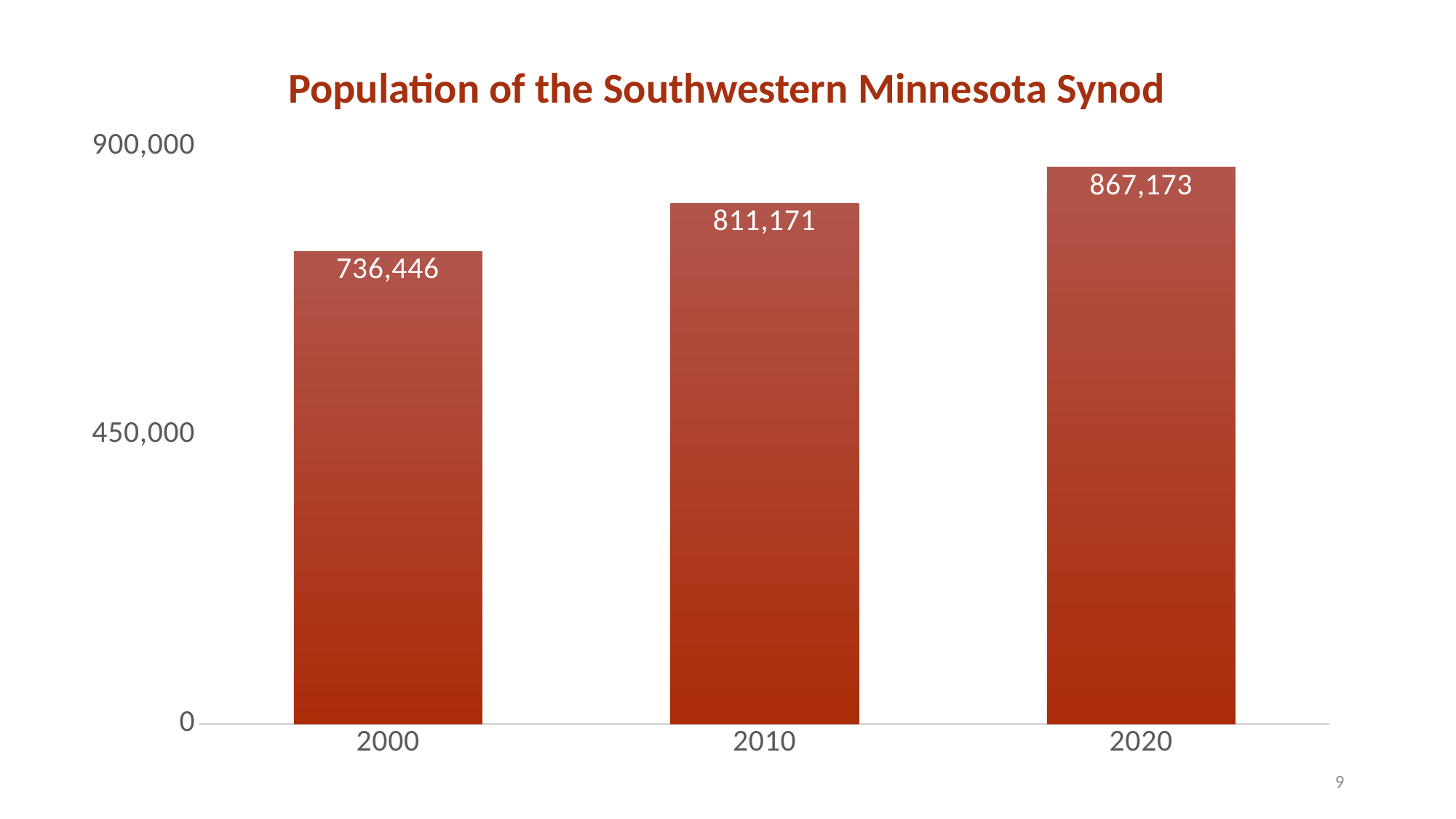
Is the population for 2000 greater or less than 450,000? greater Does the population rise or fall from 2000 to 2020? rise What is the population shown for 2010? 811,171 Which is larger, the population in 2010 or in 2020? 2020 Which year has the lowest population? 2000 How many years are shown on the chart? 3 What is the population shown for 2020? 867,173 What is the difference in population between 2020 and 2000? 130,727 Which year has the highest population? 2020 What kind of chart is this? bar chart What is the difference in population between 2010 and 2000? 74,725 What is the population shown for 2000? 736,446